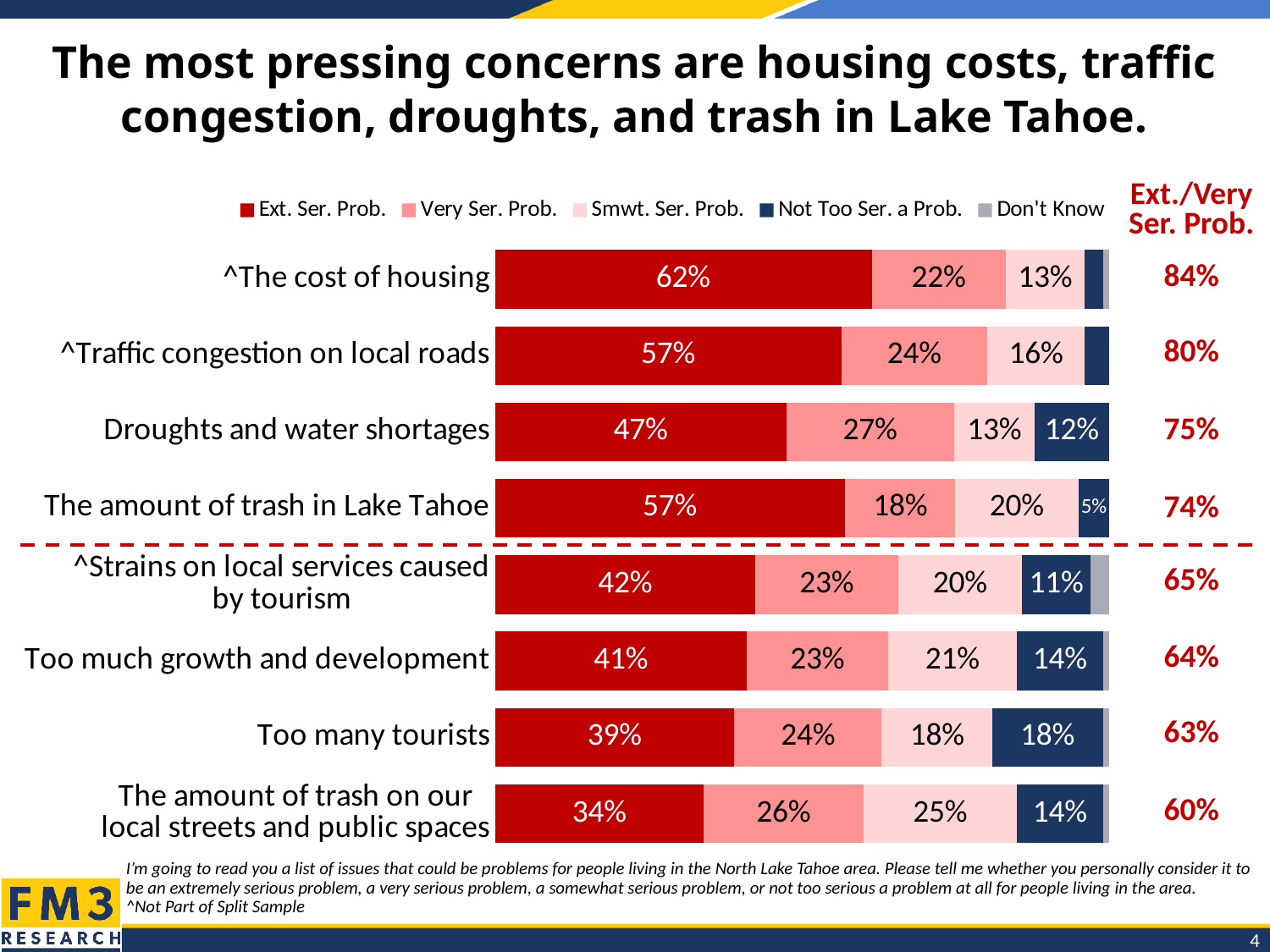
How many series does the legend list? 5 What is the difference between the Ext. Ser. Prob. values for the cost of housing and droughts and water shortages? 15% What percentage rated the cost of housing an extremely serious problem (Ext. Ser. Prob.)? 62% Which colour represents the Not Too Ser. a Prob. series in the chart? Dark navy blue What kind of chart is shown on the slide? Stacked bar chart Which issue has the lowest Ext. Ser. Prob. value? The amount of trash on our local streets and public spaces What is the Not Too Ser. a Prob. value for too many tourists? 18% What is the Very Ser. Prob. value for droughts and water shortages? 27% What is the combined Ext./Very Ser. Prob. total for too much growth and development? 64% Which is larger: the Smwt. Ser. Prob. value for the amount of trash in Lake Tahoe or for traffic congestion on local roads? The amount of trash in Lake Tahoe How many issues (categories) are plotted in the chart? 8 Which issue has the highest Ext./Very Ser. Prob. combined value? The cost of housing